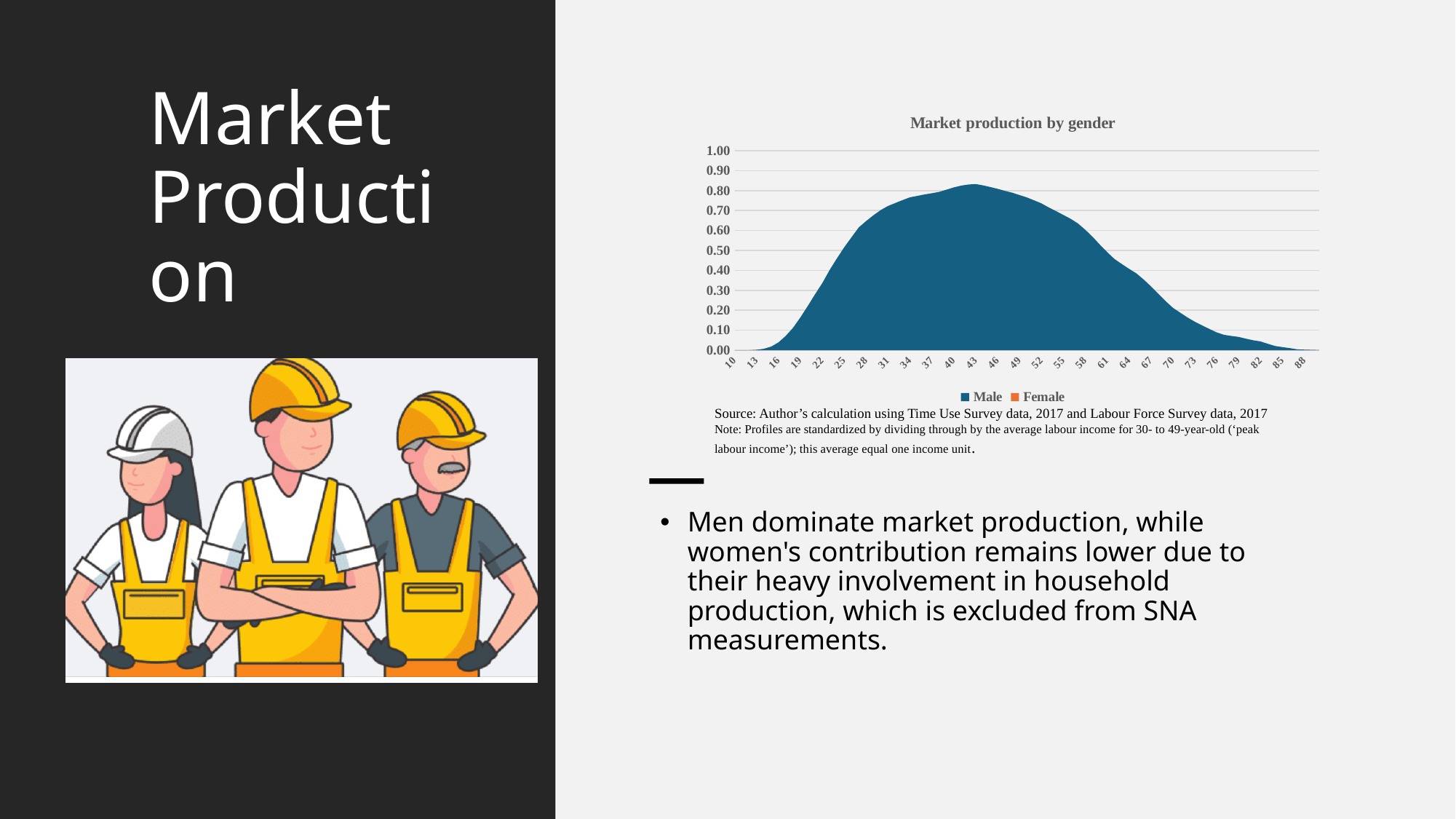
What kind of chart is shown on the slide? Area chart Does the Male series rise or fall between ages 10 and 43? Rise Is the Male value at age 13 greater or less than 0.10? less Is the Male value at age 43 greater or less than 0.70? greater Does the Male series rise or fall between ages 43 and 88? Fall How many series does the chart legend list? 2 What is the title of the chart? Market production by gender Which is larger, the Male value at age 40 or at age 67? Age 40 Is the Male value at age 70 greater or less than 0.30? less Which colour represents the Male series in the legend? Blue